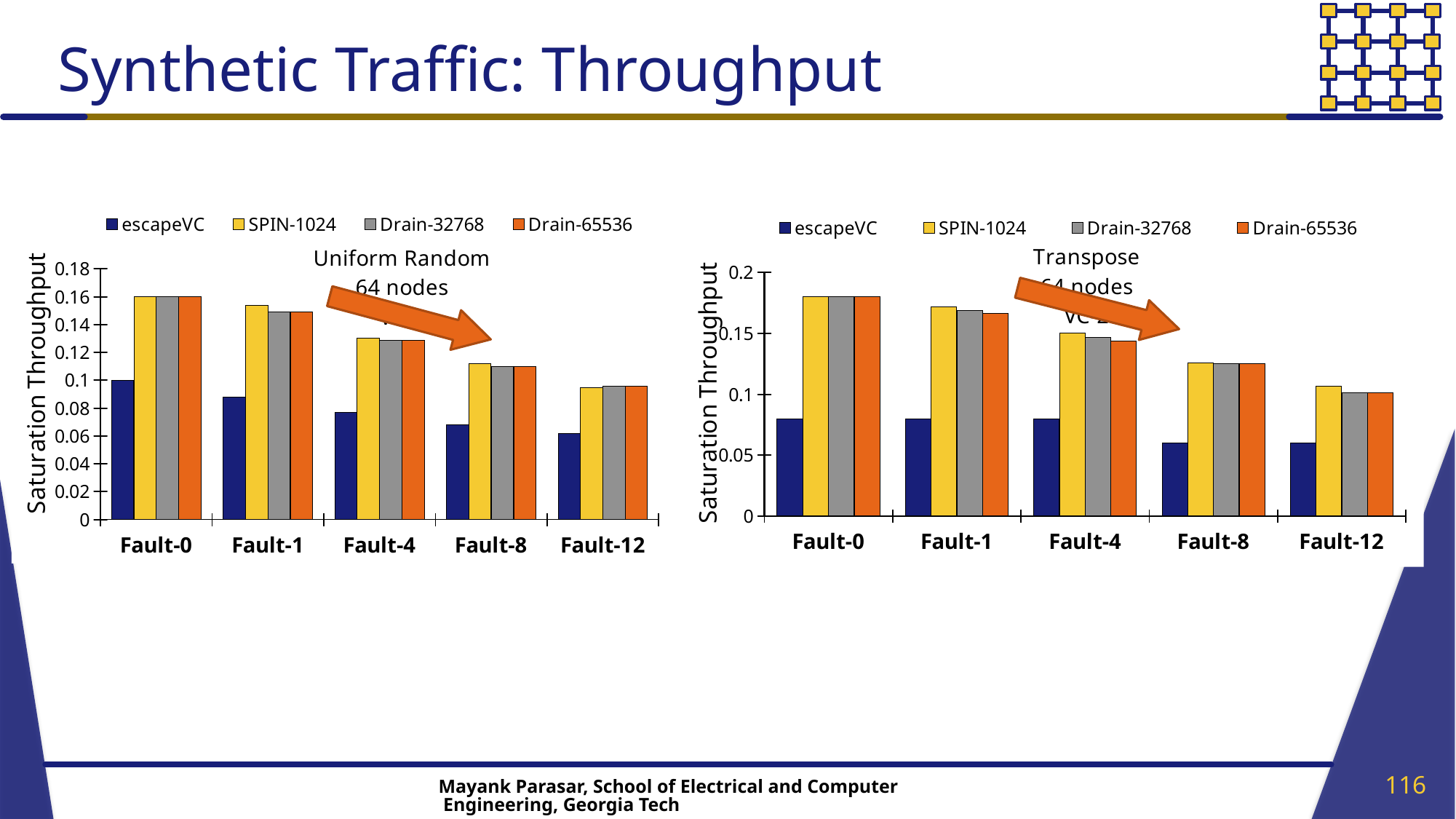
In the Uniform Random 64 nodes chart on the left, is the SPIN-1024 value for Fault-0 greater or less than 0.14? greater In the Uniform Random 64 nodes chart on the left, which fault category has the highest escapeVC value? Fault-0 How many fault categories are shown on the x axis of the Uniform Random 64 nodes chart on the left? 5 In the Transpose 64 nodes chart on the right, which fault category has the lowest SPIN-1024 value? Fault-12 What is the label on the y axis of the Transpose 64 nodes chart on the right? Saturation Throughput In the Uniform Random 64 nodes chart on the left, is the escapeVC value for Fault-12 greater or less than 0.08? less In the Uniform Random 64 nodes chart on the left, do the SPIN-1024 values rise or fall from Fault-0 to Fault-12? fall What kind of chart is the Uniform Random 64 nodes chart on the left? bar chart In the Transpose 64 nodes chart on the right, is the SPIN-1024 value for Fault-0 greater or less than 0.15? greater In the Uniform Random 64 nodes chart on the left, which is larger for Fault-4: escapeVC or SPIN-1024? SPIN-1024 How many series does the legend of the Transpose 64 nodes chart on the right list? 4